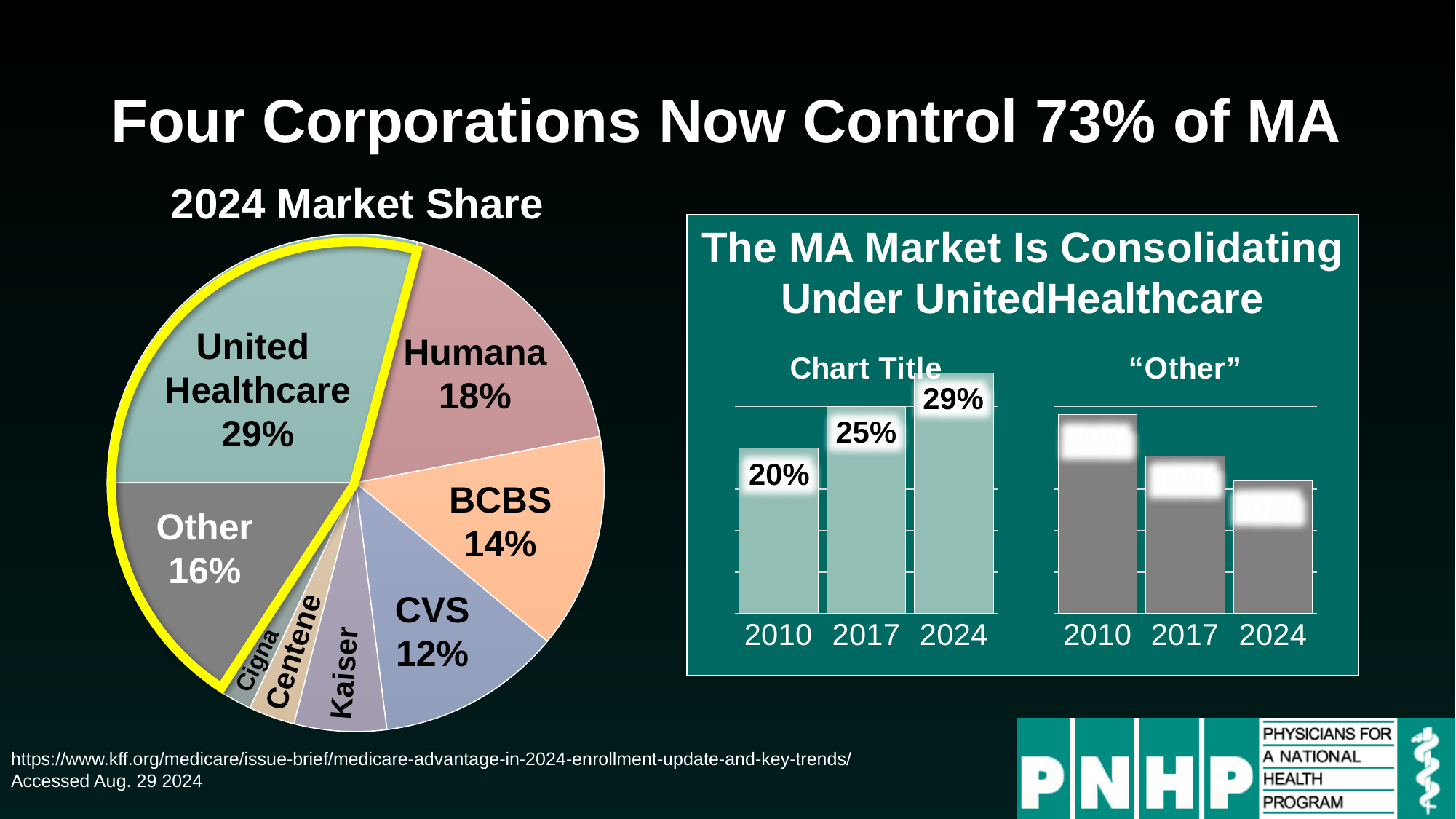
In the bar chart labelled "Chart Title" on the right, what is the value for 2010? 20% In the bar chart labelled "Chart Title" on the right, what is the value for 2017? 25% In the 2024 Market Share pie chart, what share does Humana hold? 18% In the bar chart labelled "Chart Title" on the right, do the values rise or fall from 2010 to 2024? rise In the 2024 Market Share pie chart, what share does CVS hold? 12% In the bar chart labelled "Chart Title" on the right, what is the difference between the 2024 and 2010 values? 9% In the 2024 Market Share pie chart, what share does United Healthcare hold? 29% In the 2024 Market Share pie chart, which labelled company has the largest slice? United Healthcare In the 2024 Market Share pie chart, how many percentage points larger is United Healthcare's share than Humana's? 11% In the 2024 Market Share pie chart, which is larger, the BCBS slice or the CVS slice? BCBS In the 2024 Market Share pie chart, how many slices are labelled? 8 In the 2024 Market Share pie chart, what share does BCBS hold? 14%